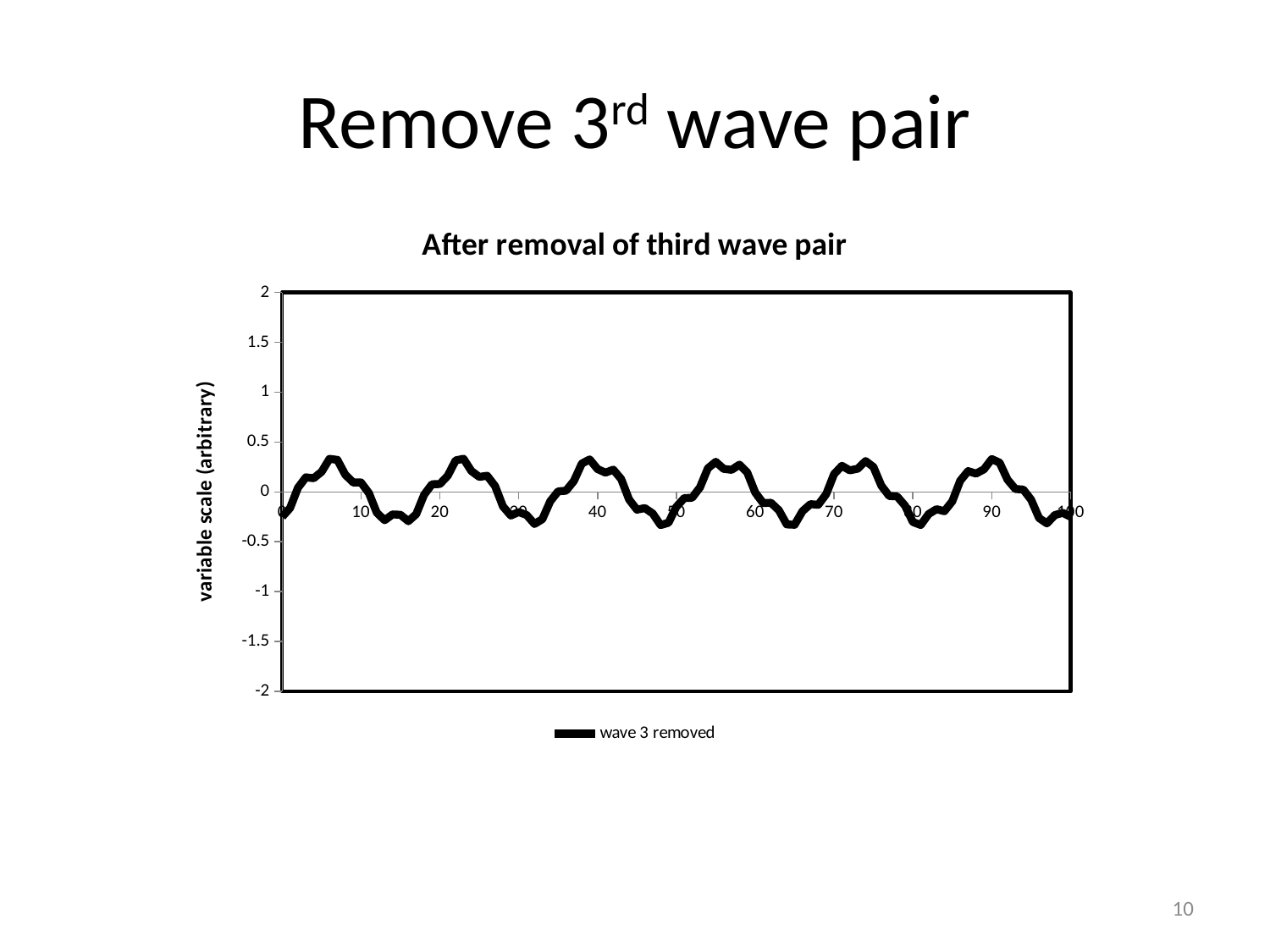
Is the lowest value reached by the line greater or less than -0.5? greater Is the highest value reached by the line greater or less than 0.5? less Is the value of the line at x = 0 greater or less than 0? less What is the name of the series shown in the legend? wave 3 removed What kind of chart is shown on the slide? line chart How many series does the legend list? 1 What is the title of the chart? After removal of third wave pair